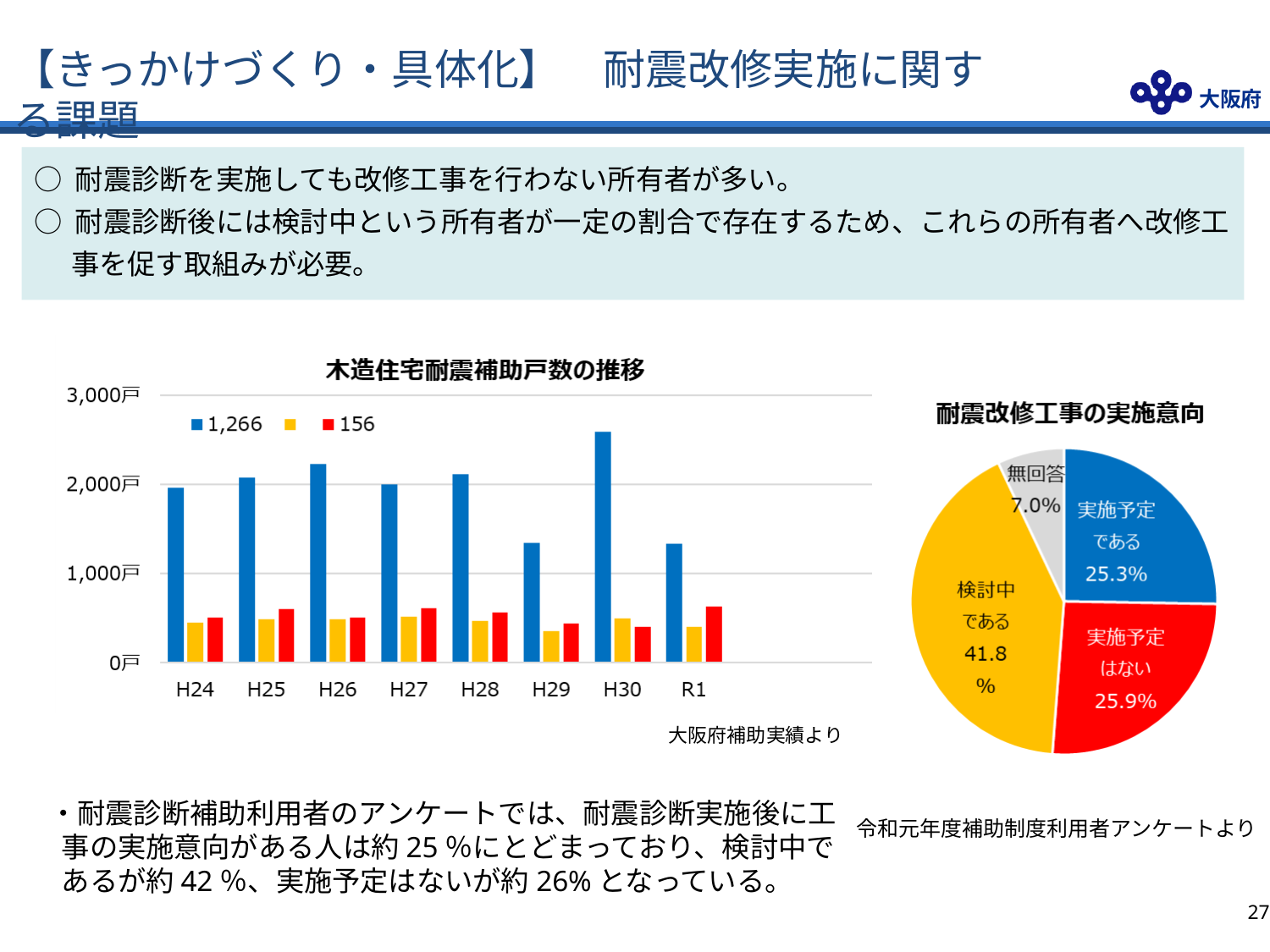
What kind of chart is 耐震改修工事の実施意向? Pie chart In the pie chart 耐震改修工事の実施意向, what is the difference between the shares of 実施予定はない and 実施予定である? 0.6% In the bar chart 木造住宅耐震補助戸数の推移, which year has the tallest blue bar? H30 In the pie chart 耐震改修工事の実施意向, how many slices are there? 4 In the pie chart 耐震改修工事の実施意向, what percentage is shown for 検討中である? 41.8% In the bar chart 木造住宅耐震補助戸数の推移, is the blue bar for H30 greater or less than 2,000戸? greater In the pie chart 耐震改修工事の実施意向, what percentage is shown for 無回答? 7.0% In the bar chart 木造住宅耐震補助戸数の推移, how many years are shown on the x axis? 8 In the pie chart 耐震改修工事の実施意向, which category has the largest share? 検討中である In the bar chart 木造住宅耐震補助戸数の推移, is the blue bar for H29 greater or less than 2,000戸? less In the pie chart 耐震改修工事の実施意向, which category has the smallest share? 無回答 In the pie chart 耐震改修工事の実施意向, what percentage is shown for 実施予定である? 25.3%